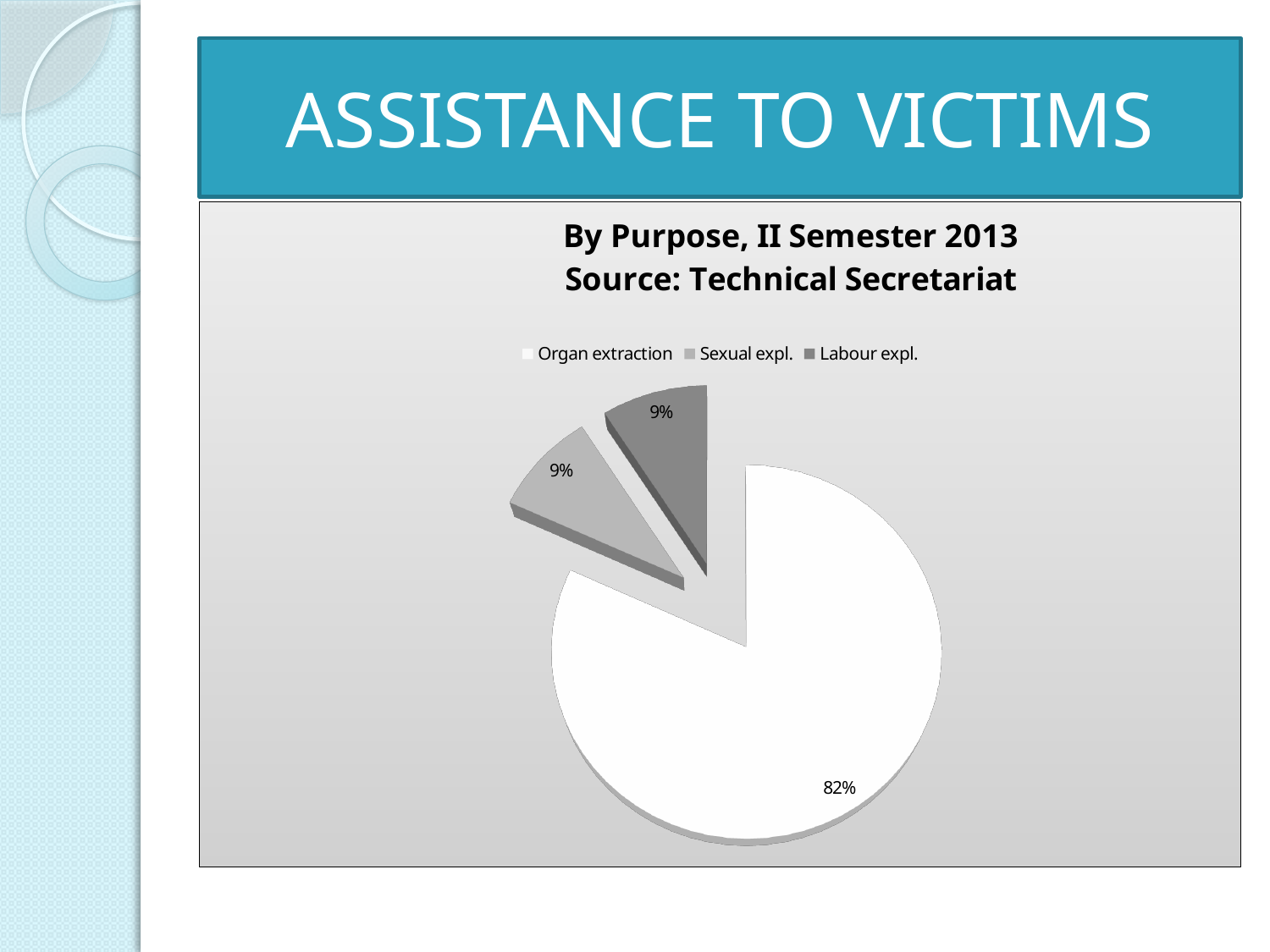
How many entries does the legend list? 3 Which category is shown in the darkest grey colour in the legend? Labour expl. What is the difference in percentage points between the Organ extraction slice and the Sexual expl. slice? 73 What is the value shown for Sexual expl.? 9% What is the value shown for Labour expl.? 9% What is the title of the chart? By Purpose, II Semester 2013 Source: Technical Secretariat Which category has the largest slice of the pie? Organ extraction What kind of chart is shown on the slide? Pie chart How many slices does the pie chart have? 3 What share of the pie does the Organ extraction slice represent? 82% Which is larger, the slice for Organ extraction or the slice for Labour expl.? Organ extraction